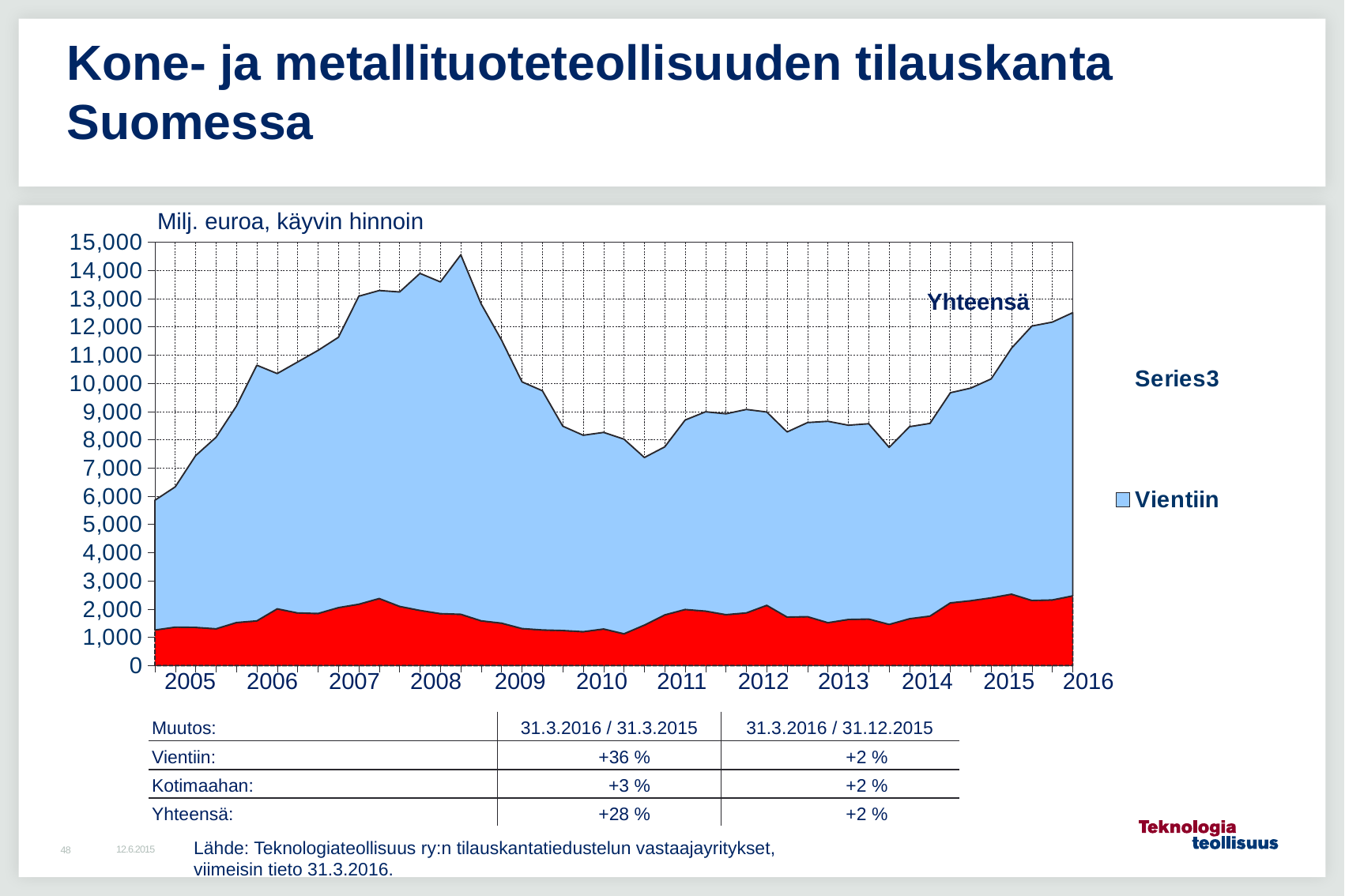
Does the Yhteensä line rise or fall between 2008 and 2010? fall How many years are labelled on the x axis of the chart? 12 Does the Yhteensä line rise or fall between 2014 and 2016? rise What are the two entries in the chart legend? Series3 and Vientiin In which year is the Yhteensä line at its lowest point? 2005 What unit label is shown above the y axis of the chart? Milj. euroa, käyvin hinnoin Is the Yhteensä value at the start of 2010 greater or less than 9,000? less Is the Yhteensä value at the peak in 2008 greater or less than 14,000? greater In which year does the Yhteensä line reach its highest point? 2008 Is the Yhteensä value at the end of the chart in 2016 greater or less than 12,000? greater How many series does the chart legend list? 2 What kind of chart is shown on the slide? Area chart